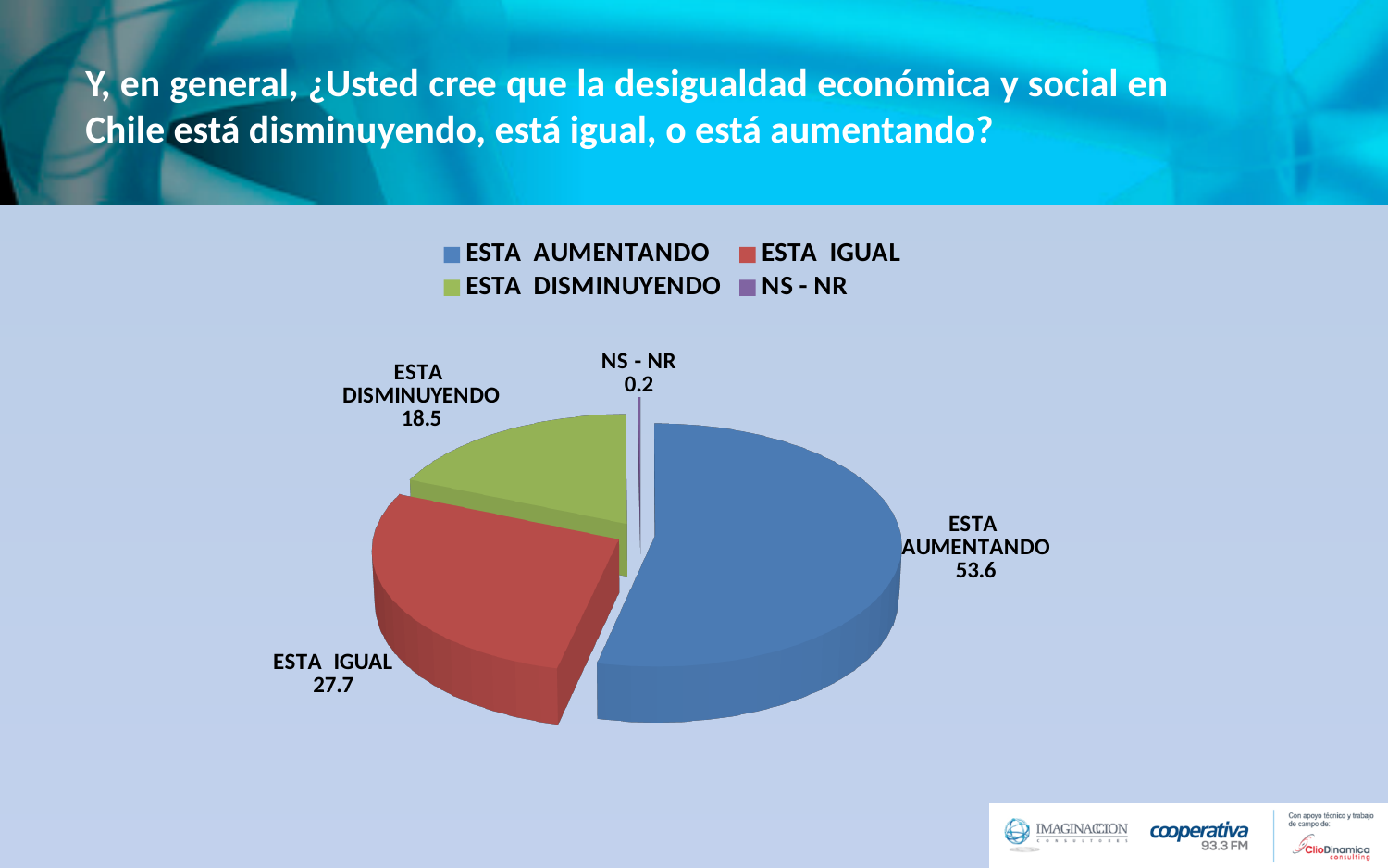
What is the difference between the values for ESTA IGUAL and ESTA DISMINUYENDO? 9.2 What is the value for ESTA AUMENTANDO? 53.6 What is the value for ESTA IGUAL? 27.7 Which category has the largest slice? ESTA AUMENTANDO What kind of chart is shown on the slide? Pie chart What is the value for NS - NR? 0.2 Which is larger, ESTA IGUAL or ESTA DISMINUYENDO? ESTA IGUAL Which category has the smallest slice? NS - NR How many categories does the pie chart have? 4 What is the difference between the values for ESTA AUMENTANDO and ESTA IGUAL? 25.9 What colour is the ESTA DISMINUYENDO slice? Green What is the value for ESTA DISMINUYENDO? 18.5